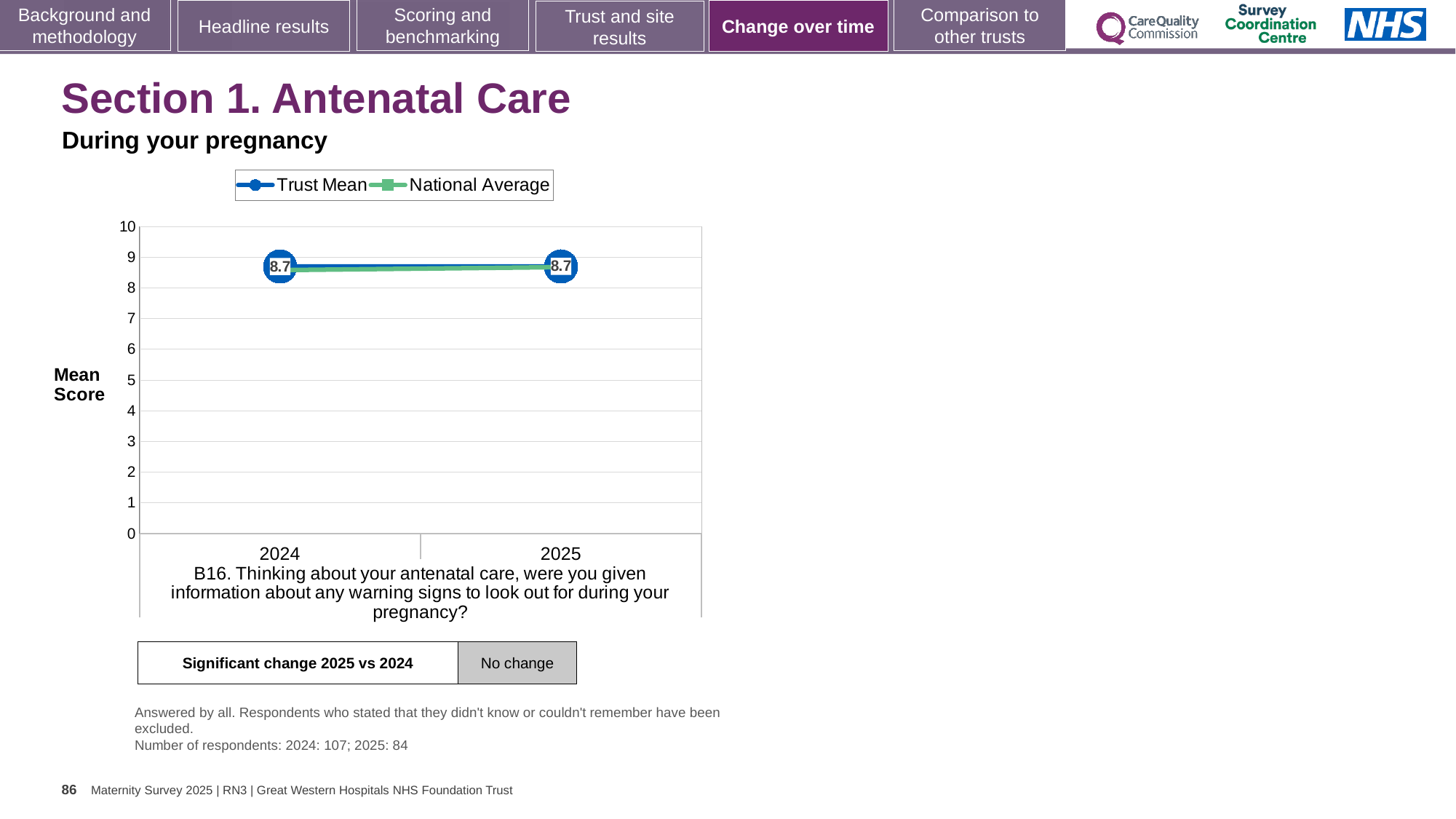
How many years are plotted on the x axis? 2 How many series does the legend list? 2 What is the Trust Mean score for 2025? 8.7 What kind of chart is shown on the slide? Line chart What is the maximum value shown on the y axis? 10 Is the National Average value for 2024 greater or less than 5? greater What is the difference between the Trust Mean score in 2025 and in 2024? 0 What are the two series named in the legend? Trust Mean and National Average What is the Trust Mean score for 2024? 8.7 Does the Trust Mean rise, fall or stay the same from 2024 to 2025? Stays the same Is the National Average value for 2025 greater or less than 8? greater What is the label on the y axis of the chart? Mean Score